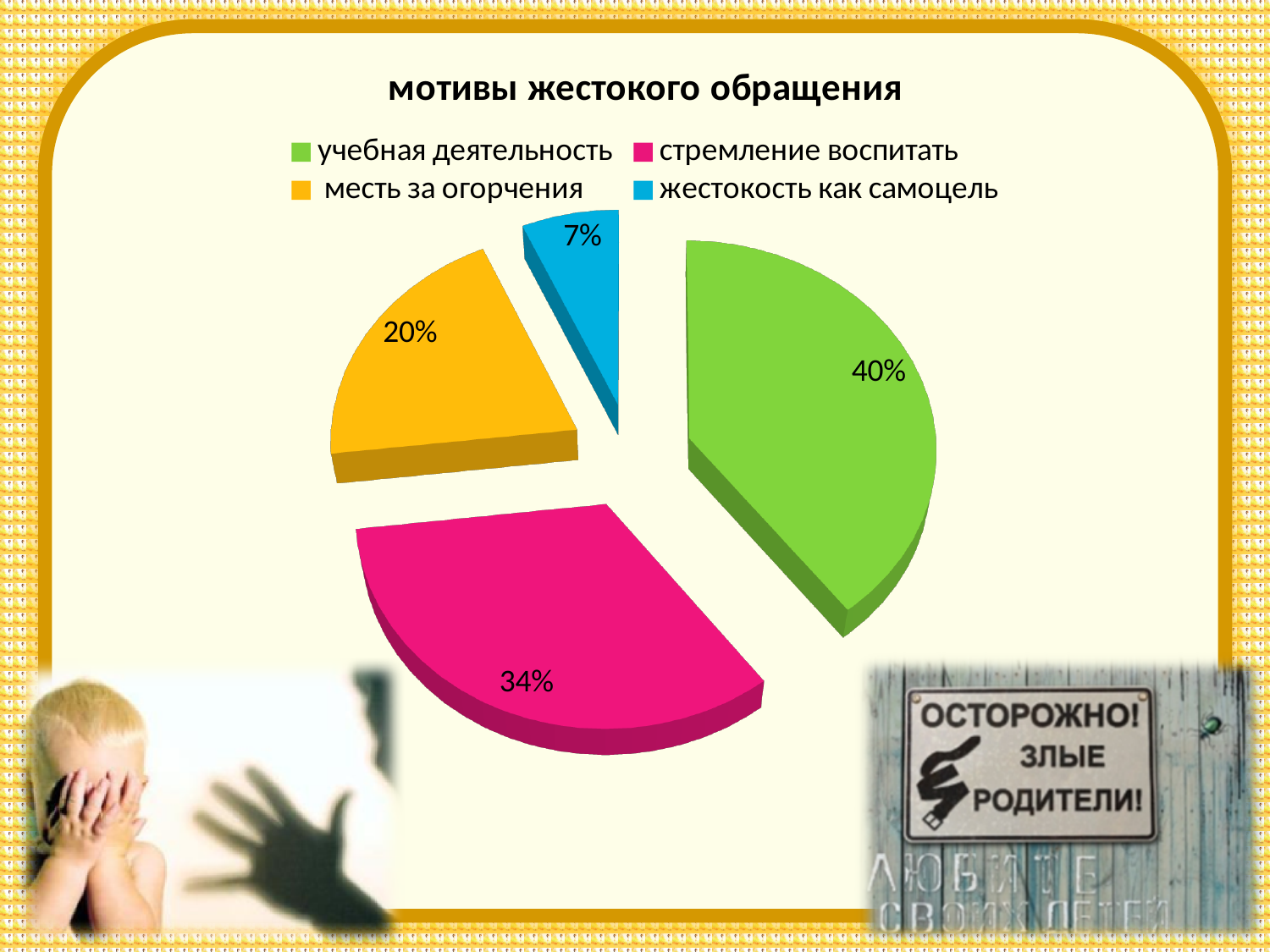
What share of the pie is labelled for жестокость как самоцель? 7% Which colour represents стремление воспитать in the legend? Pink What share of the pie is labelled for учебная деятельность? 40% Which category has the largest slice of the pie? учебная деятельность Which is larger: the slice for месть за огорчения or the slice for жестокость как самоцель? месть за огорчения What is the title of the chart? мотивы жестокого обращения What is the difference in percentage points between учебная деятельность and стремление воспитать? 6 What type of chart is shown on the slide? Pie chart Which category has the smallest slice of the pie? жестокость как самоцель What share of the pie is labelled for стремление воспитать? 34% How many categories does the pie chart show? 4 What share of the pie is labelled for месть за огорчения? 20%